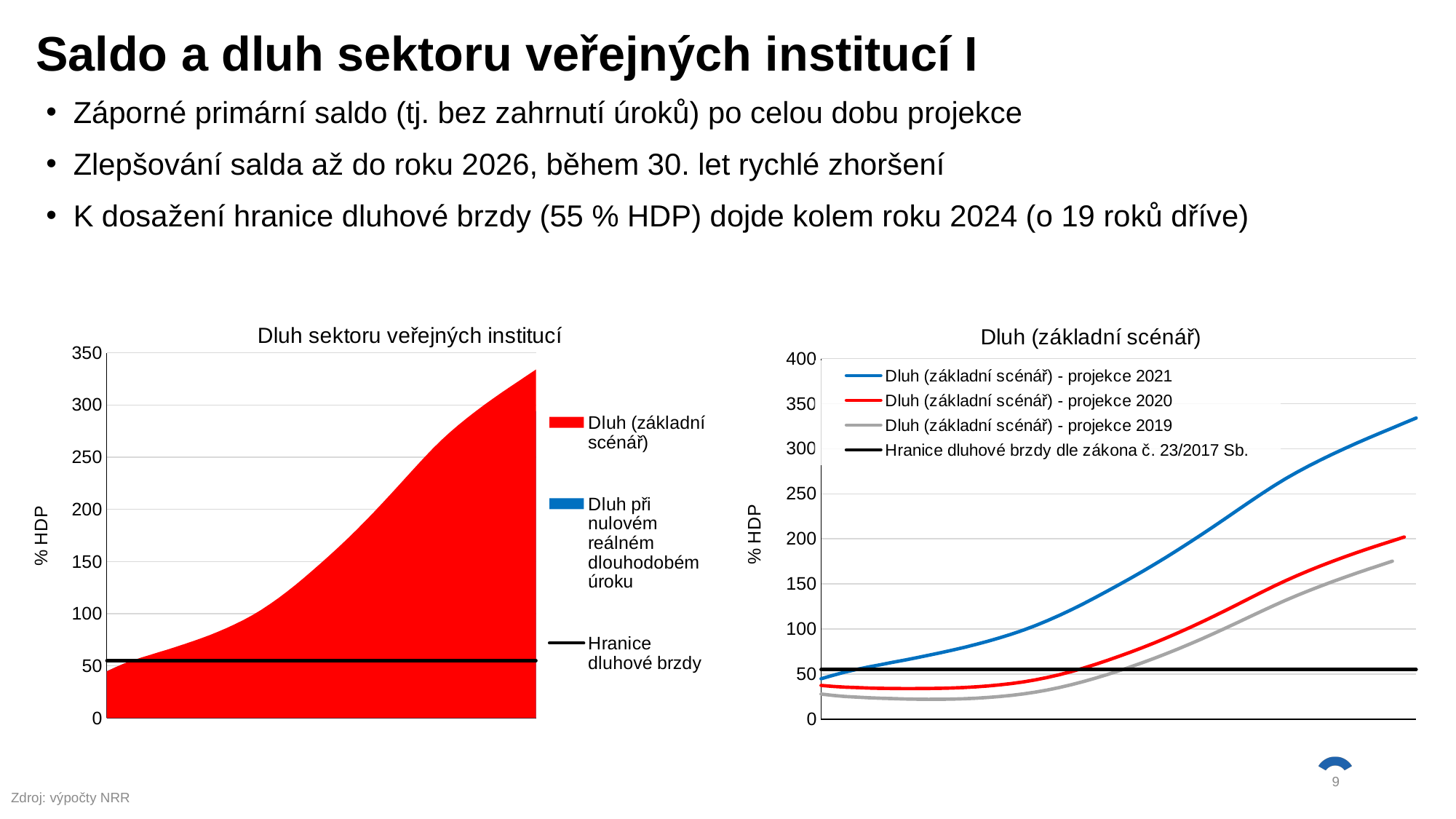
How many entries does the legend of the left chart "Dluh sektoru veřejných institucí" list? 3 In the right chart "Dluh (základní scénář)", is the final value of the "projekce 2019" series greater or less than 150? greater In the right chart "Dluh (základní scénář)", is the final value of the "projekce 2021" series greater or less than 300? greater In the right chart "Dluh (základní scénář)", is the "Hranice dluhové brzdy dle zákona č. 23/2017 Sb." line greater or less than 100? less In the right chart "Dluh (základní scénář)", do the values of the "projekce 2021" series rise or fall along the x axis? rise In the left chart "Dluh sektoru veřejných institucí", does the red "Dluh (základní scénář)" area rise or fall along the x axis? rise In the right chart "Dluh (základní scénář)", at the right end of the chart, which series is higher: "projekce 2021" or "projekce 2019"? projekce 2021 What is the y-axis label of the right chart "Dluh (základní scénář)"? % HDP How many series does the legend of the right chart "Dluh (základní scénář)" list? 4 What kind of chart is the right chart titled "Dluh (základní scénář)"? line chart What kind of chart is the left chart titled "Dluh sektoru veřejných institucí"? area chart